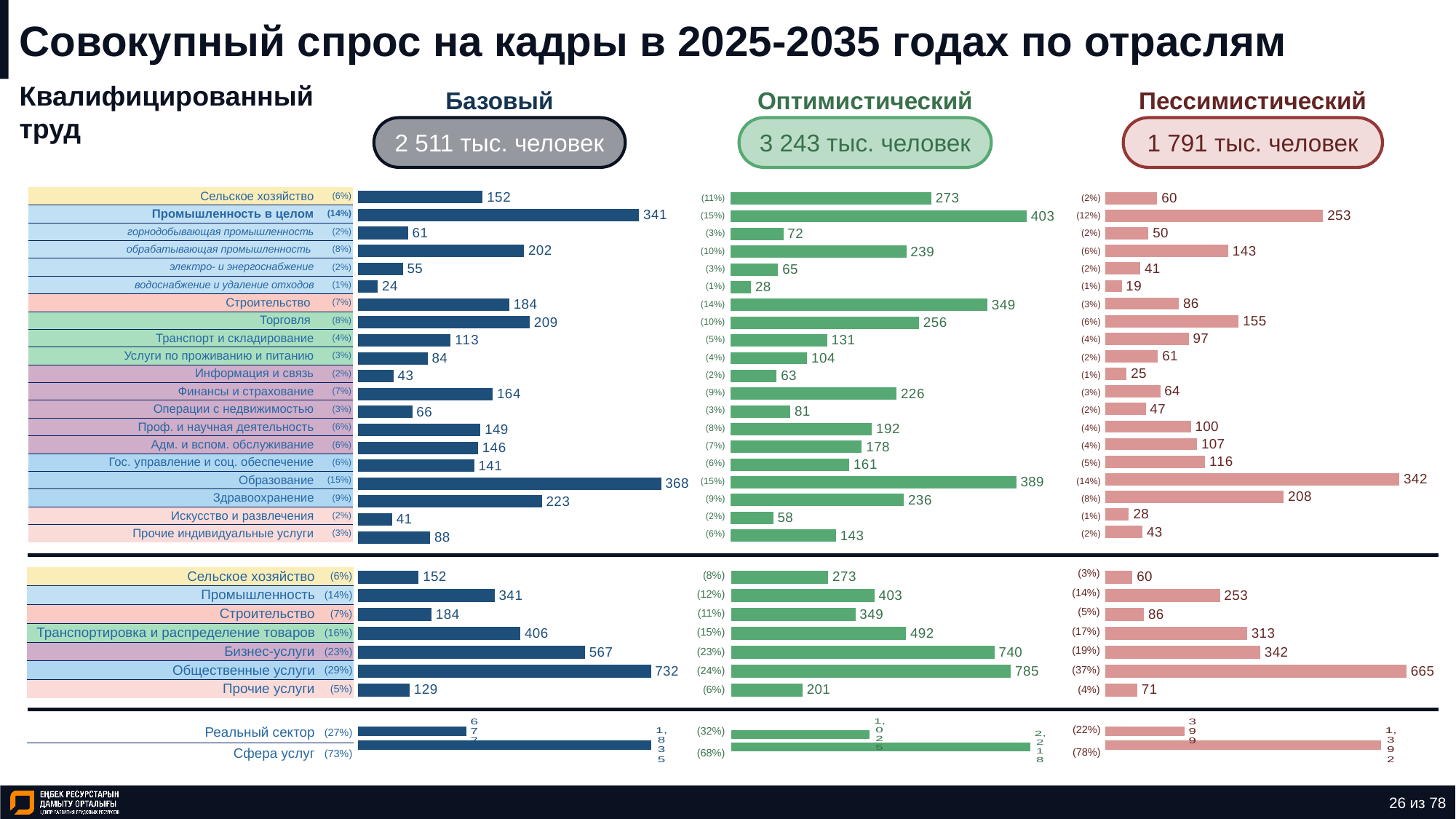
In the Оптимистический chart, what is the difference between Промышленность в целом and Образование? 14 In the Оптимистический chart, what is the value for Строительство? 349 What total is shown in the header for the Оптимистический scenario? 3 243 тыс. человек In the Базовый chart (upper section), which category has the lowest value? водоснабжение и удаление отходов What kind of chart is used for the Базовый scenario? Bar chart In the Пессимистический chart, what is the difference between Образование and Сельское хозяйство? 282 In the Базовый chart, what is the value for Образование? 368 In the Пессимистический chart, which is larger: Торговля or Строительство? Торговля In the Базовый chart (middle section), what is the value for Общественные услуги? 732 How many categories are shown in the middle section of the Базовый chart (from Сельское хозяйство to Прочие услуги)? 7 In the Базовый chart (upper section), which category has the highest value? Образование In the Пессимистический chart, what is the value for Здравоохранение? 208